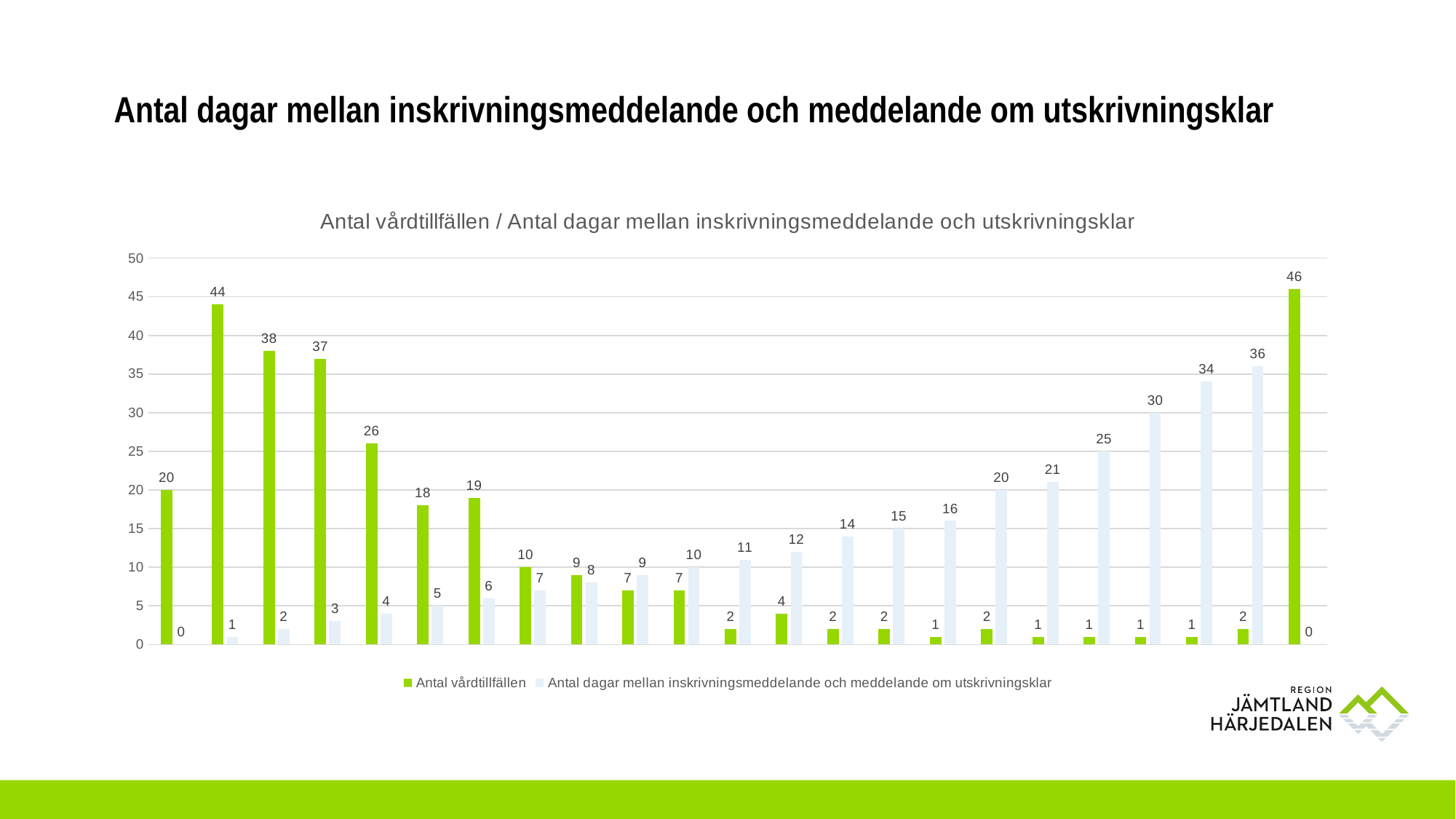
What type of chart is shown on the slide? bar chart What is the highest value of the 'Antal vårdtillfällen' series? 46 What is the highest value of the 'Antal dagar mellan inskrivningsmeddelande och meddelande om utskrivningsklar' series? 36 In the group where the number of days is 30, what is the value of 'Antal vårdtillfällen'? 1 How many series does the legend list? 2 How many groups of bars are plotted along the x axis? 23 Which is larger in the group where the number of days is 8: 'Antal vårdtillfällen' or the number of days? Antal vårdtillfällen What is the difference between the 'Antal vårdtillfällen' values in the second and third groups from the left (44 and 38)? 6 What is the value of 'Antal vårdtillfällen' in the first group of bars on the left? 20 What is the value of 'Antal vårdtillfällen' in the second group of bars from the left? 44 Does the 'Antal dagar' series generally rise or fall from left to right across the first 22 groups? rise What is the title of the chart? Antal vårdtillfällen / Antal dagar mellan inskrivningsmeddelande och utskrivningsklar